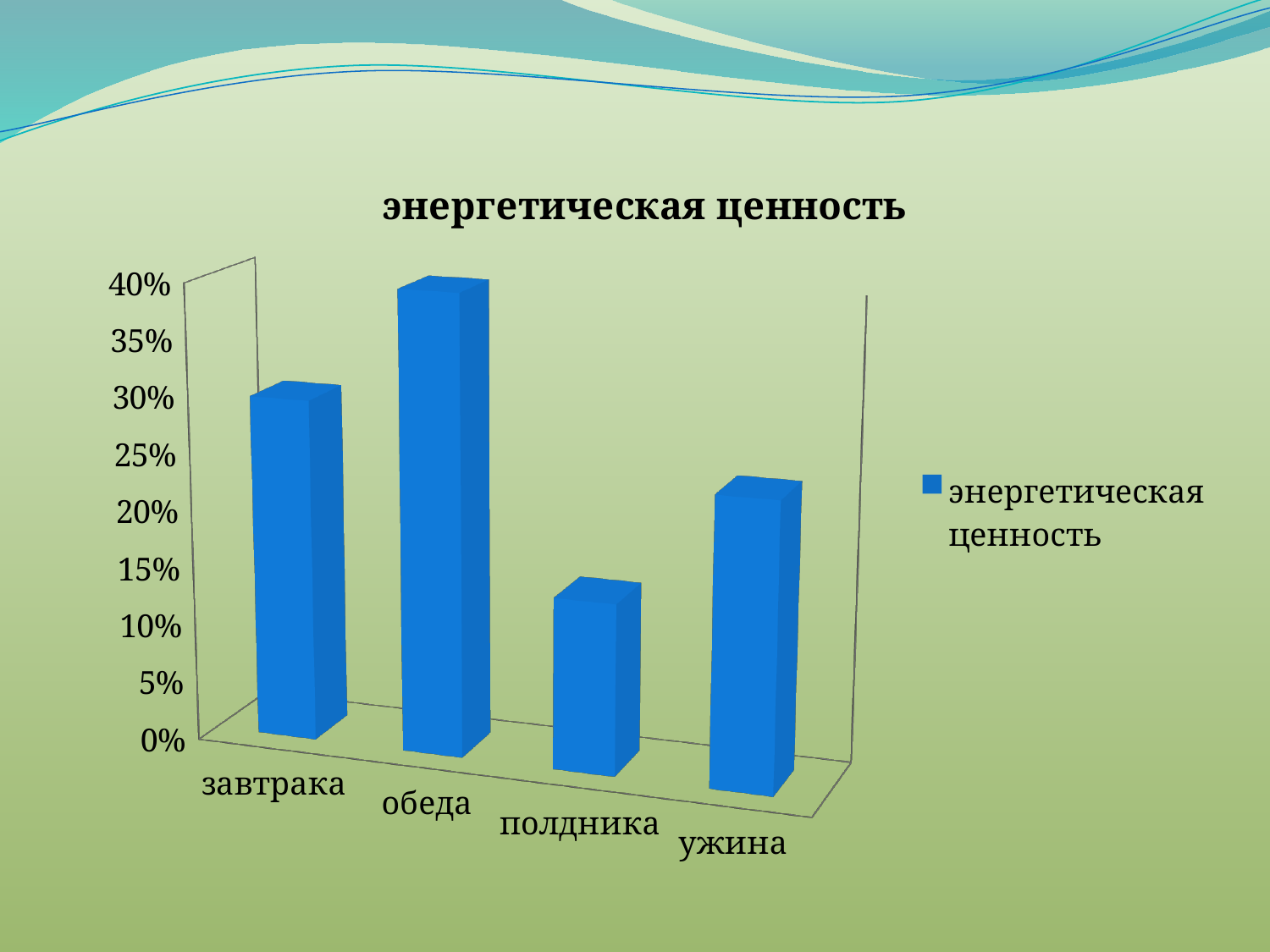
What kind of chart is shown on the slide? bar chart How many categories are shown on the x axis of the chart? 4 Is the value for ужина greater or less than 30%? less Which category has the lowest energy value (энергетическая ценность)? полдника Which category has the highest energy value (энергетическая ценность)? обеда Is the value for обеда greater or less than 35%? greater Which is larger, the value for полдника or the value for ужина? ужина What is the title of the chart? энергетическая ценность How many series does the legend list? 1 Is the value for завтрака greater or less than 20%? greater Which is larger, the value for завтрака or the value for ужина? завтрака